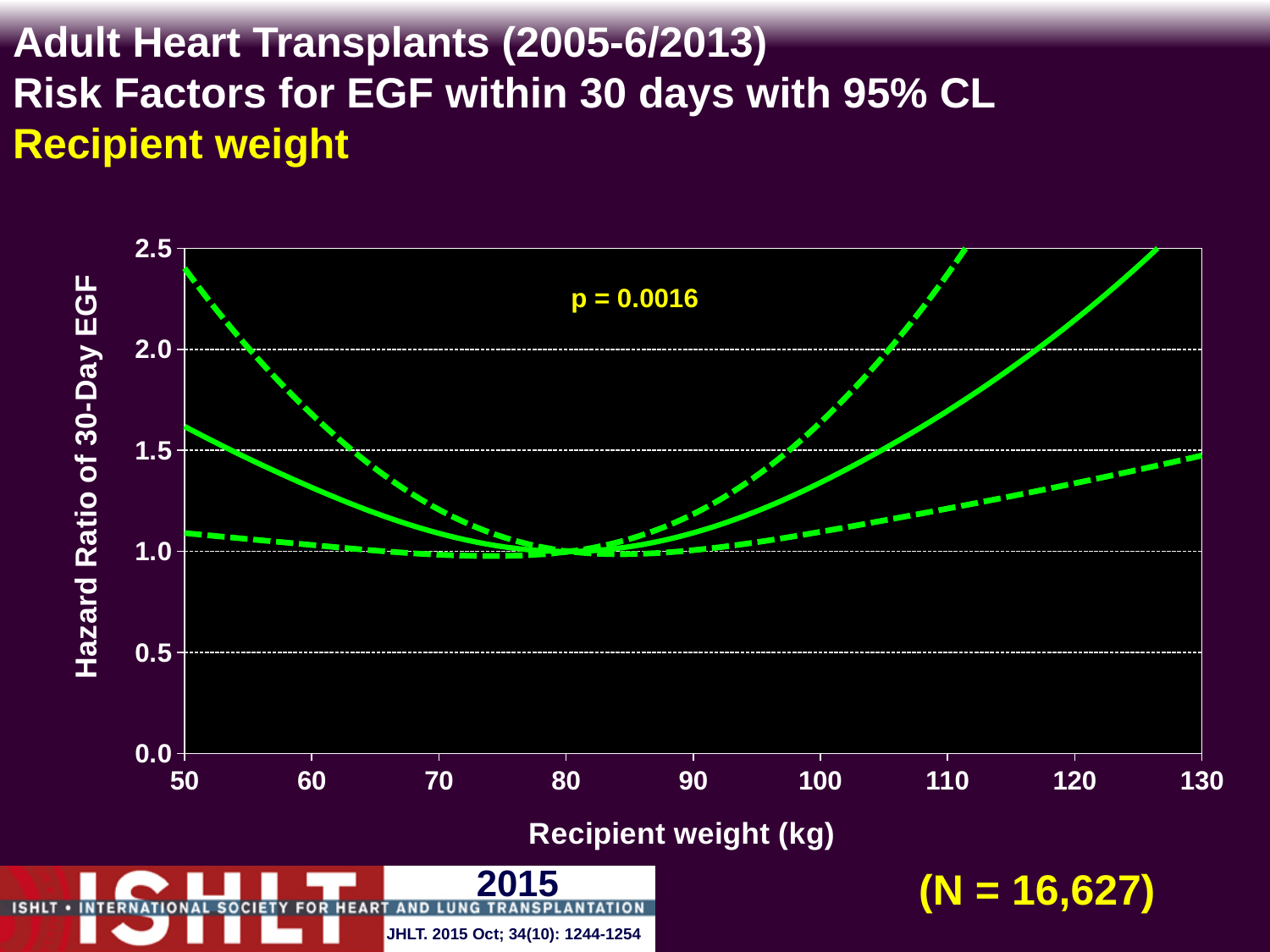
Is the value of the upper dashed confidence limit at a recipient weight of 90 kg greater or less than 1.5? less Does the solid hazard ratio line rise or fall as recipient weight increases from 50 kg to 80 kg? fall How many curves are plotted on the chart? 3 Does the solid hazard ratio line rise or fall as recipient weight increases from 90 kg to 130 kg? rise What p-value is printed on the chart? p = 0.0016 Is the value of the solid hazard ratio line at a recipient weight of 50 kg greater or less than 1.5? greater Is the value of the solid hazard ratio line at a recipient weight of 100 kg greater or less than 1.5? less What sample size (N) is shown on the slide? N = 16,627 What kind of chart is shown on the slide? line chart Is the solid hazard ratio line higher at a recipient weight of 120 kg or at 80 kg? 120 kg